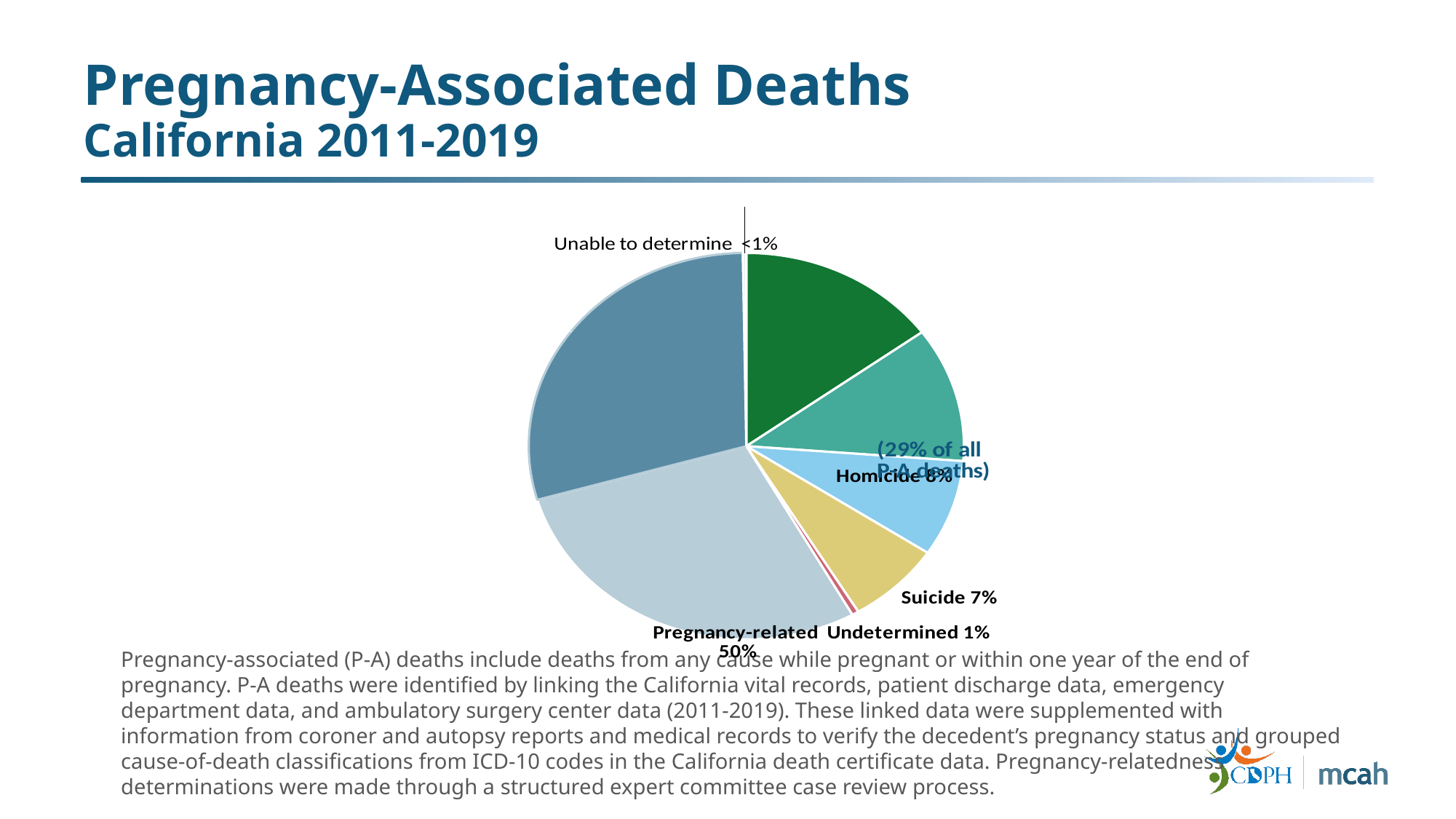
What percentage is shown for Suicide? 7% What is the difference in percentage points between Pregnancy-related and Homicide? 42 percentage points Which labelled category has the smallest slice of the pie? Unable to determine What kind of chart is shown on the slide? pie chart What value is shown for the Unable to determine slice? <1% Which is larger, the Homicide slice or the Suicide slice? Homicide What is the title of the slide containing the pie chart? Pregnancy-Associated Deaths California 2011-2019 What percentage is shown for Undetermined? 1% What percentage is shown for Homicide? 8% Which labelled category has the largest slice of the pie? Pregnancy-related What is the difference in percentage points between Homicide and Suicide? 1 percentage point What percentage of pregnancy-associated deaths is labelled as Pregnancy-related? 50%